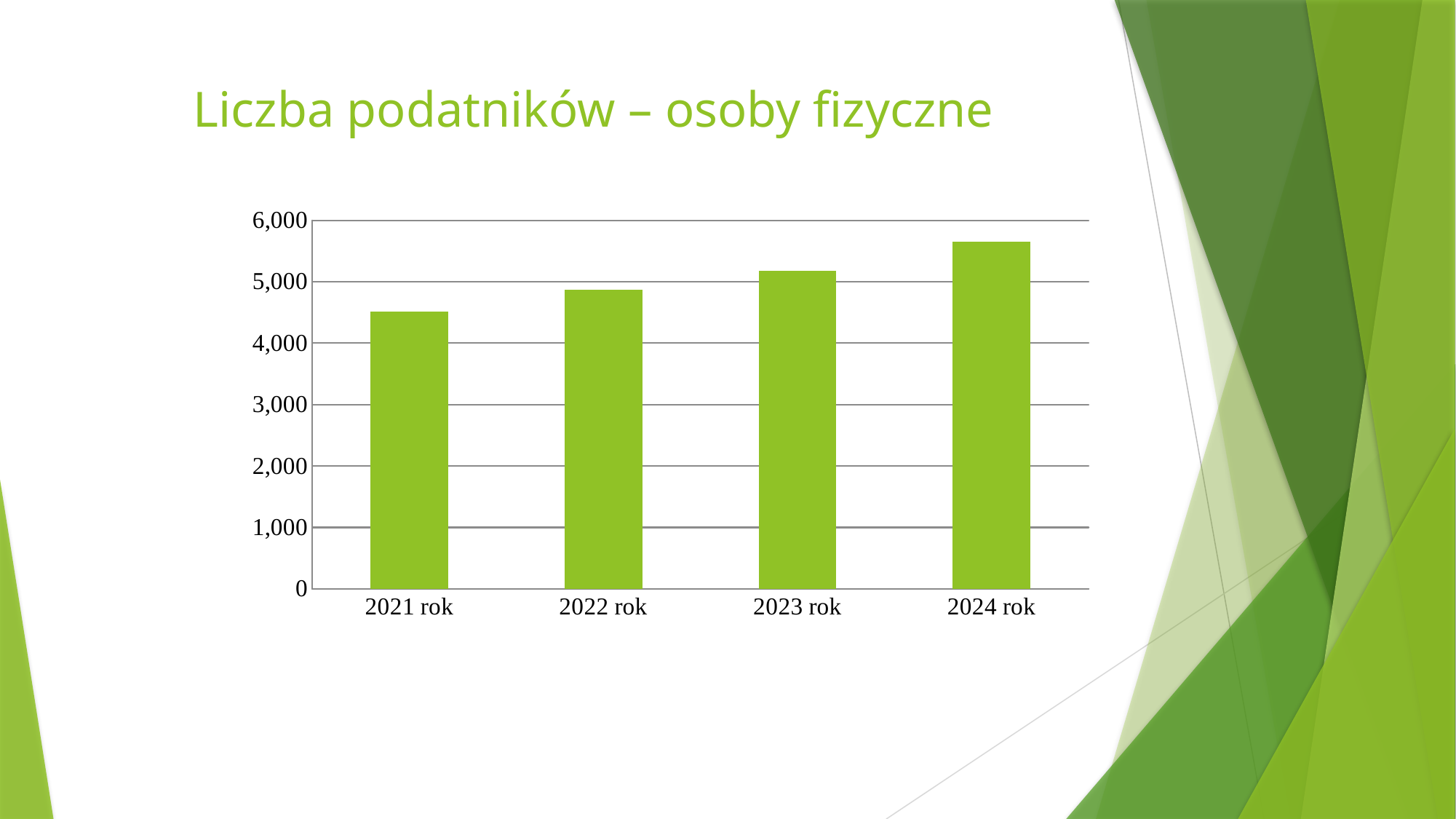
Is the value for 2024 rok greater or less than 6,000? less What colour are the bars in the chart? green Is the value for 2021 rok greater or less than 5,000? less How many years (categories) are shown on the x axis? 4 Is the value for 2021 rok greater or less than 4,000? greater Which year has the highest value? 2024 rok What is the title of the chart? Liczba podatników – osoby fizyczne Which year has the lowest value? 2021 rok What kind of chart is shown on the slide? bar chart Which is larger, the value for 2022 rok or the value for 2023 rok? 2023 rok Do the values rise or fall from 2021 rok to 2024 rok? rise